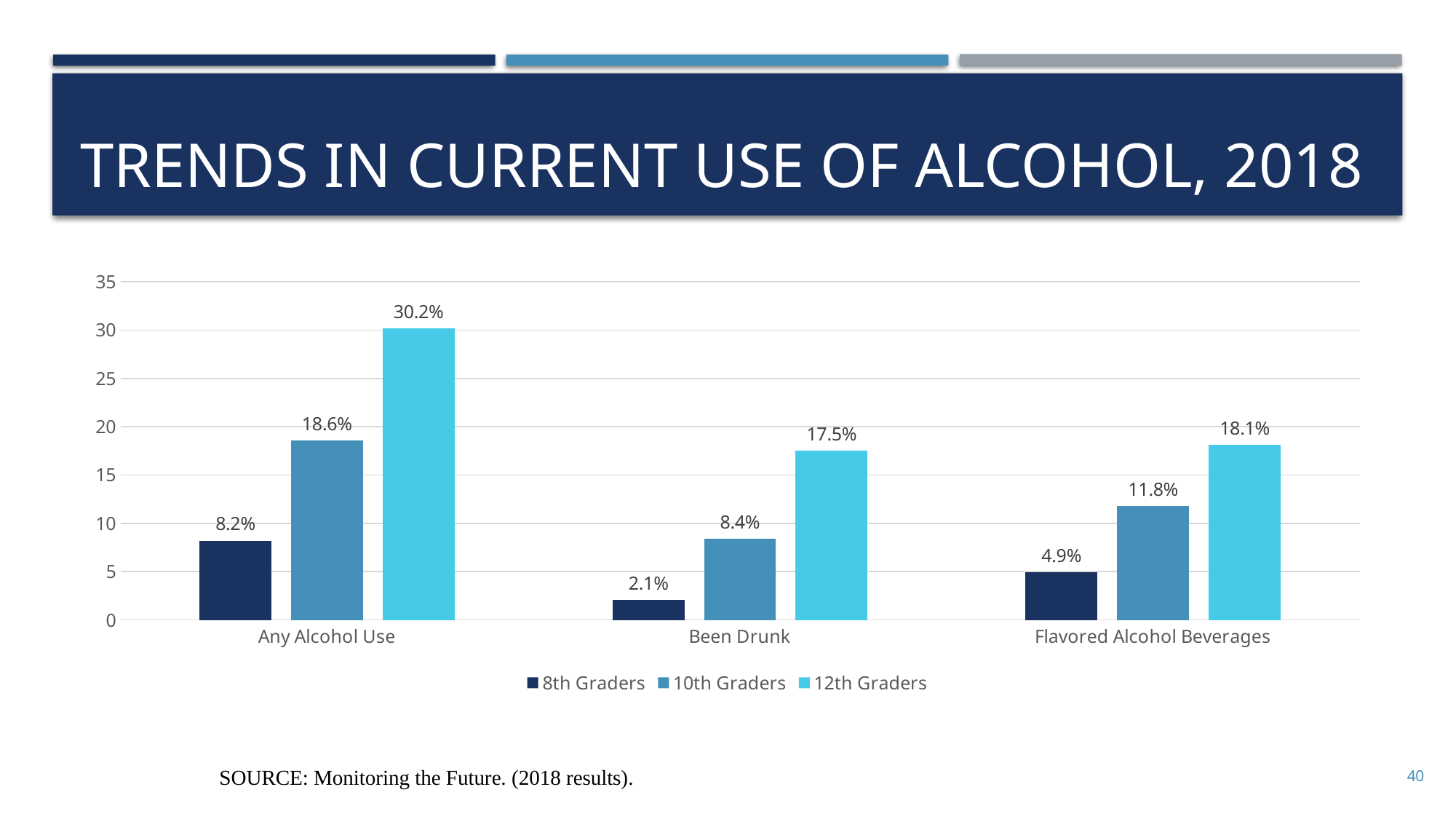
What is the value for 8th Graders for Been Drunk? 2.1% Is the value for 12th Graders for Flavored Alcohol Beverages greater or less than 20? less What kind of chart is shown on the slide? Bar chart Which category has the highest value for 12th Graders? Any Alcohol Use How many categories are shown on the x axis? 3 What is the value for 12th Graders for Any Alcohol Use? 30.2% Which category has the lowest value for 8th Graders? Been Drunk What is the difference between the 12th Graders and 8th Graders values for Any Alcohol Use? 22.0% Which is larger: the 10th Graders value for Any Alcohol Use or the 12th Graders value for Been Drunk? 10th Graders value for Any Alcohol Use What is the value for 10th Graders for Flavored Alcohol Beverages? 11.8% How many series does the legend list? 3 What is the title of the slide? TRENDS IN CURRENT USE OF ALCOHOL, 2018